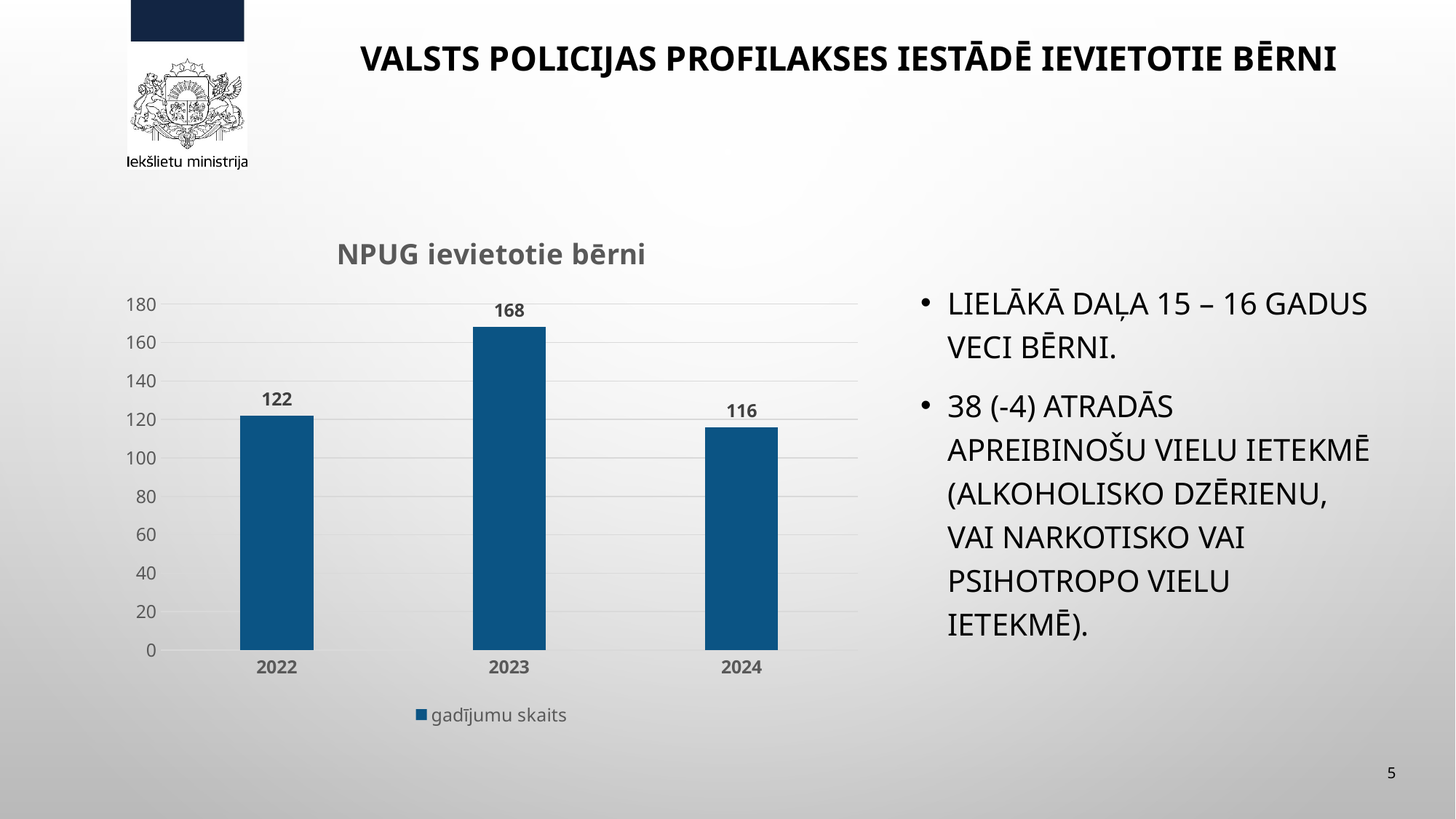
What kind of chart is shown? bar chart What is the title of the chart? NPUG ievietotie bērni Is the value for 2023 greater or less than 160? greater Which is larger, the value for 2022 or the value for 2024? 2022 What is the value for 2022? 122 What is the difference between the values for 2023 and 2022? 46 What is the value for 2024? 116 Which year has the highest value? 2023 What is the difference between the values for 2022 and 2024? 6 What is the value for 2023? 168 How many years are shown on the x axis? 3 Which year has the lowest value? 2024